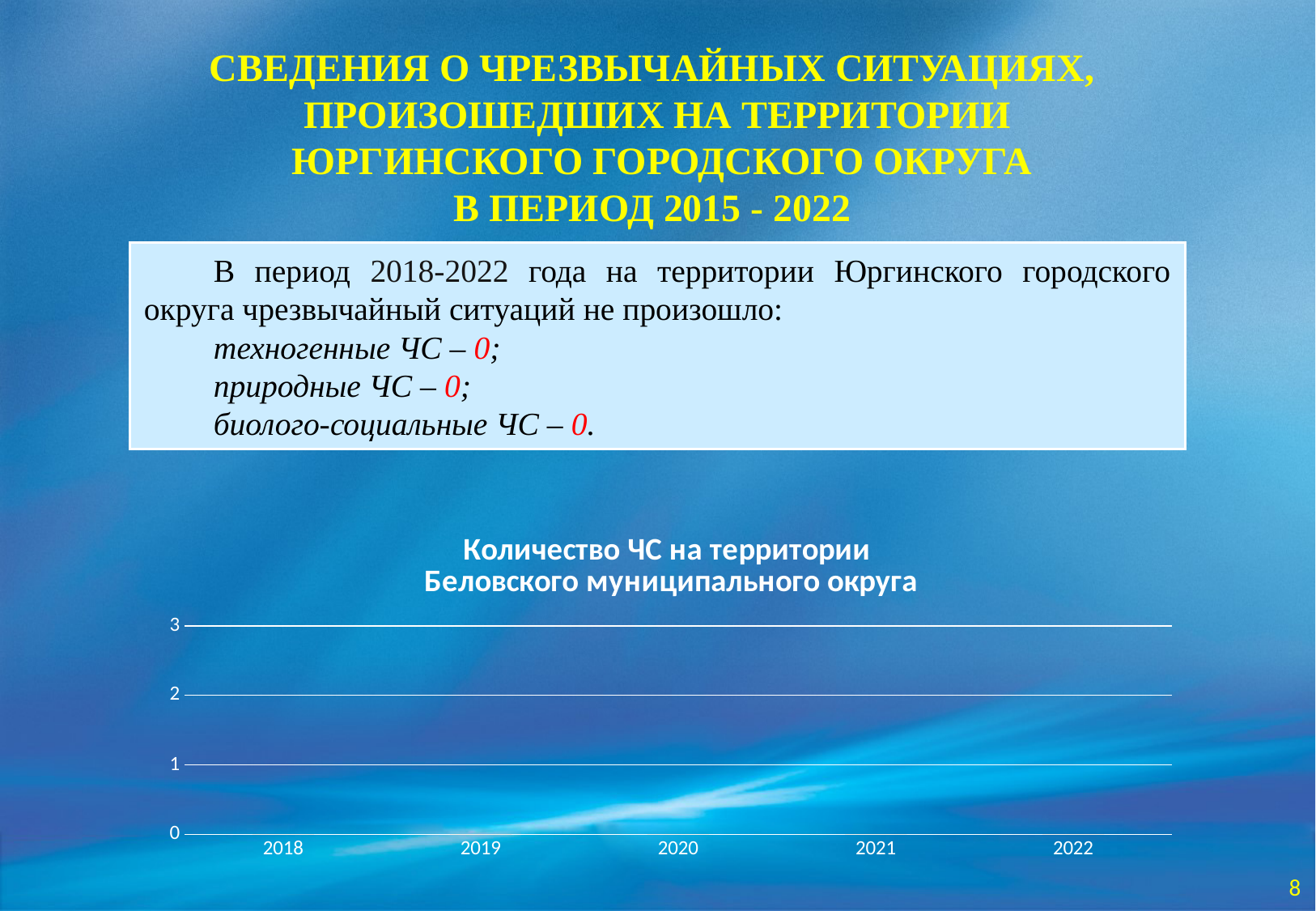
What is the highest value shown on the y axis of the chart? 3 Does the chart show any year with a value greater than 0? No What is the first year shown on the x axis of the chart? 2018 Is the value for 2020 in the chart greater or less than 2? less How many years are shown on the x axis of the chart? 5 Is the value for 2018 in the chart greater or less than 1? less What is the title of the chart on the slide? Количество ЧС на территории Беловского муниципального округа